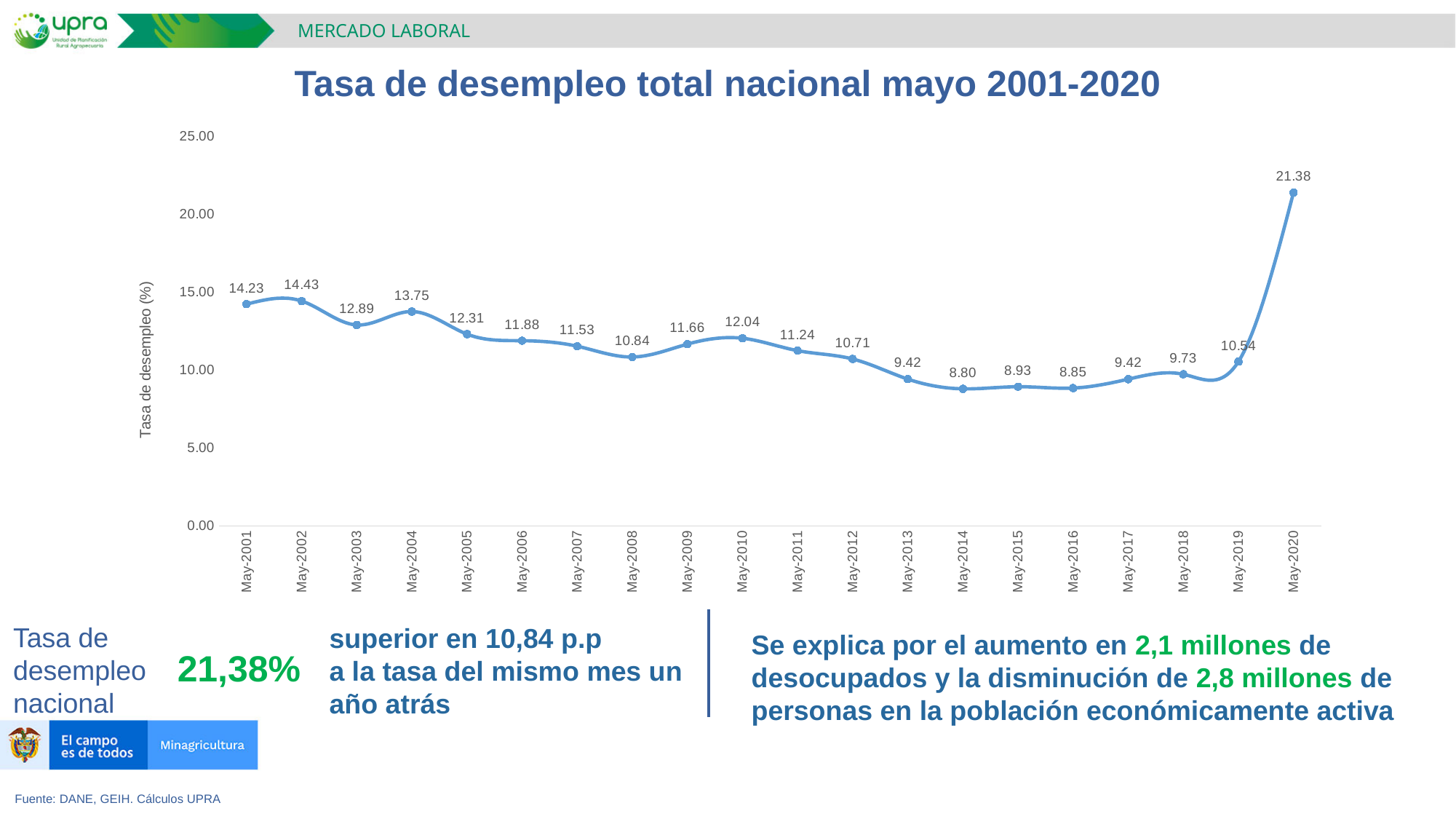
Which month-year has the highest unemployment rate on the chart? May-2020 What is the unemployment rate shown for May-2004? 13.75 What is the title of the chart? Tasa de desempleo total nacional mayo 2001-2020 What is the difference between the unemployment rate in May-2020 and May-2019? 10.84 Which is larger, the unemployment rate in May-2010 or in May-2012? May-2010 What is the unemployment rate shown for May-2020? 21.38 Does the unemployment rate rise or fall from May-2001 to May-2008? fall What type of chart is shown on the slide? line chart How many data points are plotted on the chart? 20 Which month-year has the lowest unemployment rate on the chart? May-2014 What is the difference between the unemployment rate in May-2002 and May-2003? 1.54 What is the unemployment rate shown for May-2014? 8.80